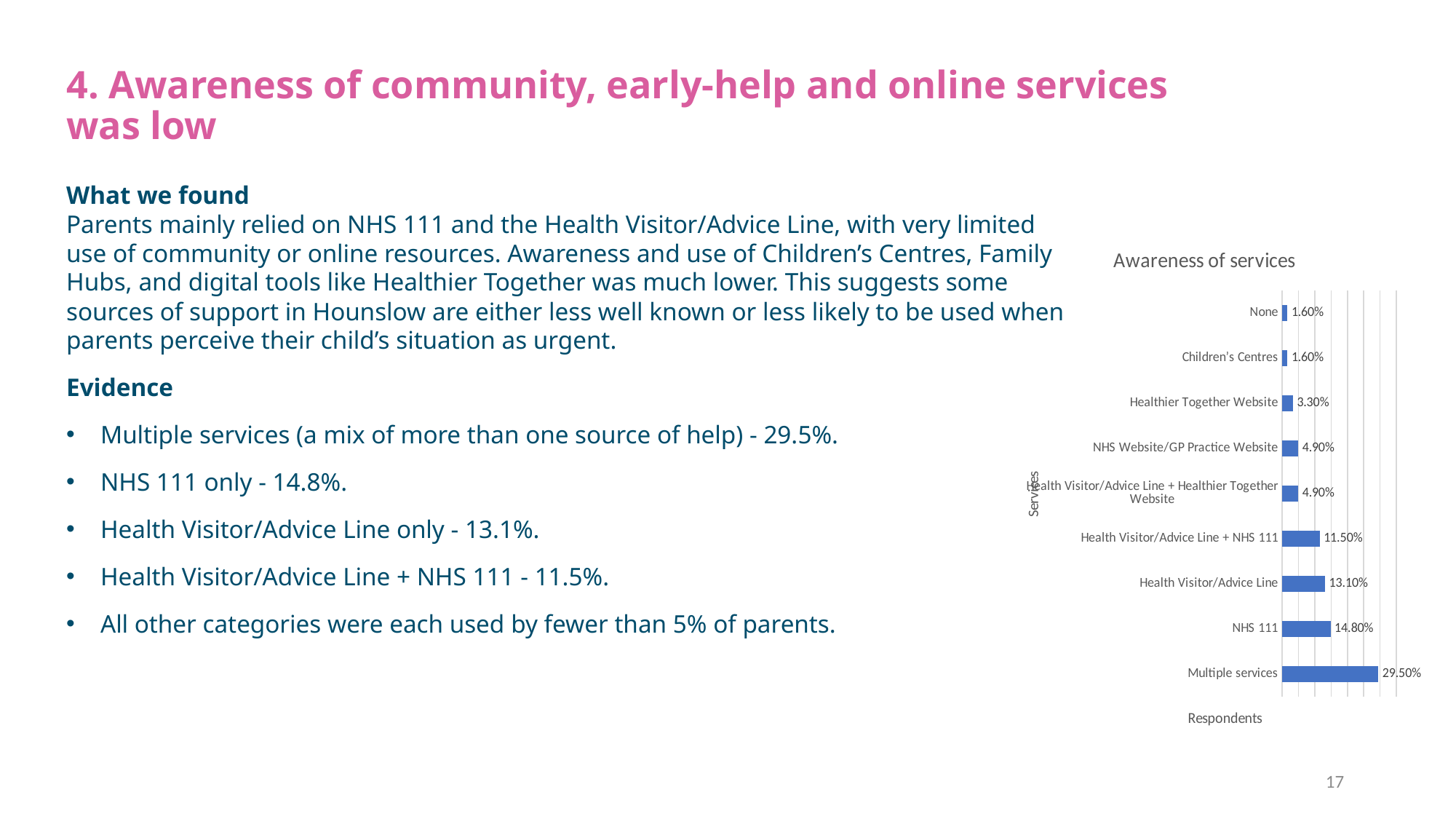
What is the label on the horizontal axis of the Awareness of services chart? Respondents What kind of chart is the Awareness of services chart? Bar chart What is the value for Health Visitor/Advice Line + NHS 111 in the Awareness of services chart? 11.50% What is the value for Multiple services in the Awareness of services chart? 29.50% What is the value for Healthier Together Website in the Awareness of services chart? 3.30% How many categories are shown in the Awareness of services chart? 9 Which is larger in the Awareness of services chart: NHS Website/GP Practice Website or Healthier Together Website? NHS Website/GP Practice Website What is the value for NHS 111 in the Awareness of services chart? 14.80% Which category has the highest value in the Awareness of services chart? Multiple services Which is larger in the Awareness of services chart: NHS 111 or Health Visitor/Advice Line? NHS 111 What is the difference between the values for Health Visitor/Advice Line and Health Visitor/Advice Line + NHS 111 in the Awareness of services chart? 1.60% What is the difference between the values for Multiple services and NHS 111 in the Awareness of services chart? 14.70%